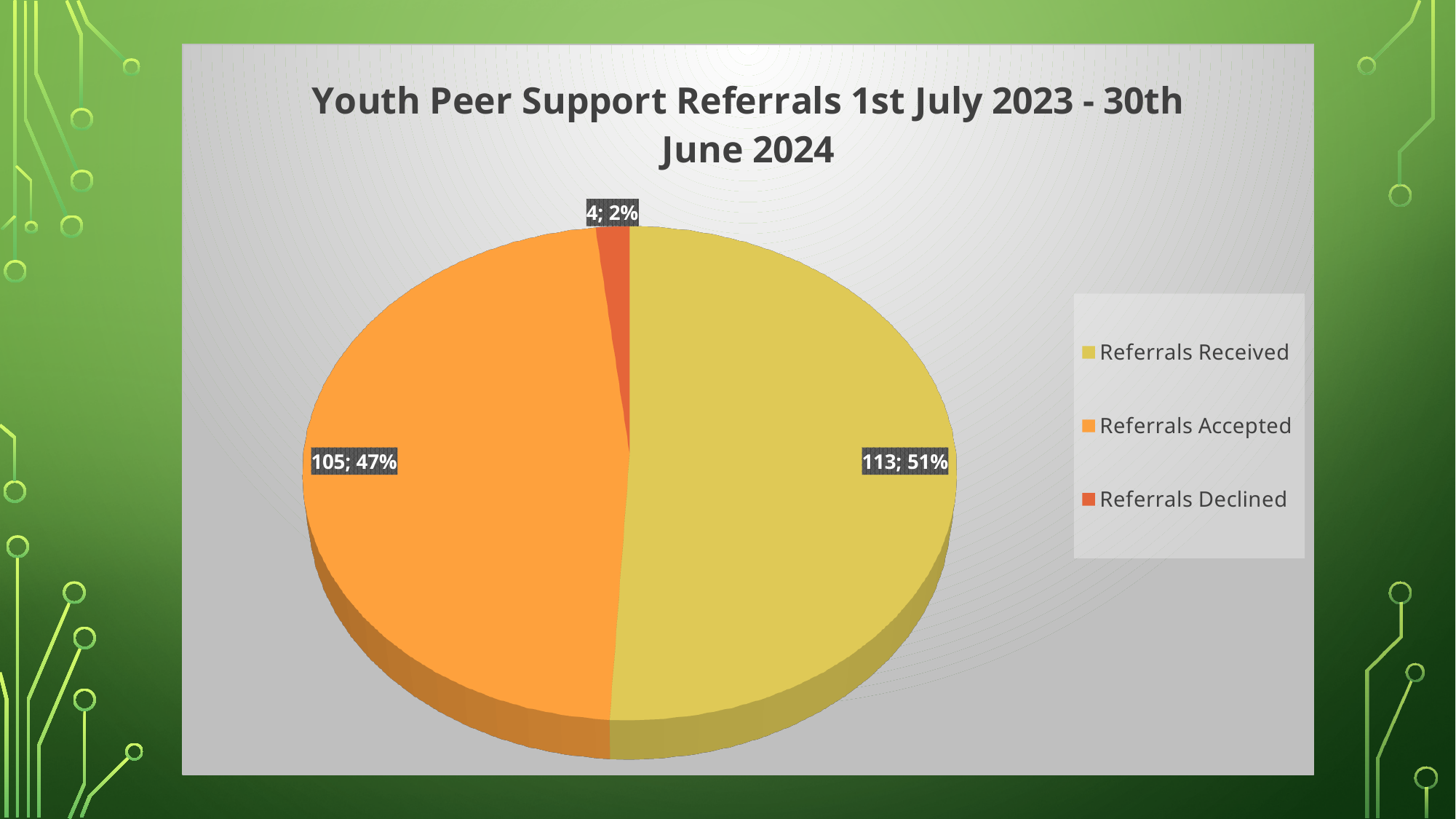
What share of the pie is Referrals Declined? 2% Which category has the smallest slice? Referrals Declined How many categories does the pie chart show? 3 Which is larger, Referrals Accepted or Referrals Declined? Referrals Accepted What is the value for Referrals Received? 113 Which category has the largest slice? Referrals Received What is the value for Referrals Declined? 4 What is the value for Referrals Accepted? 105 What kind of chart is shown on the slide? Pie chart What is the difference between Referrals Received and Referrals Accepted? 8 What share of the pie is Referrals Received? 51% What is the title of the chart? Youth Peer Support Referrals 1st July 2023 - 30th June 2024